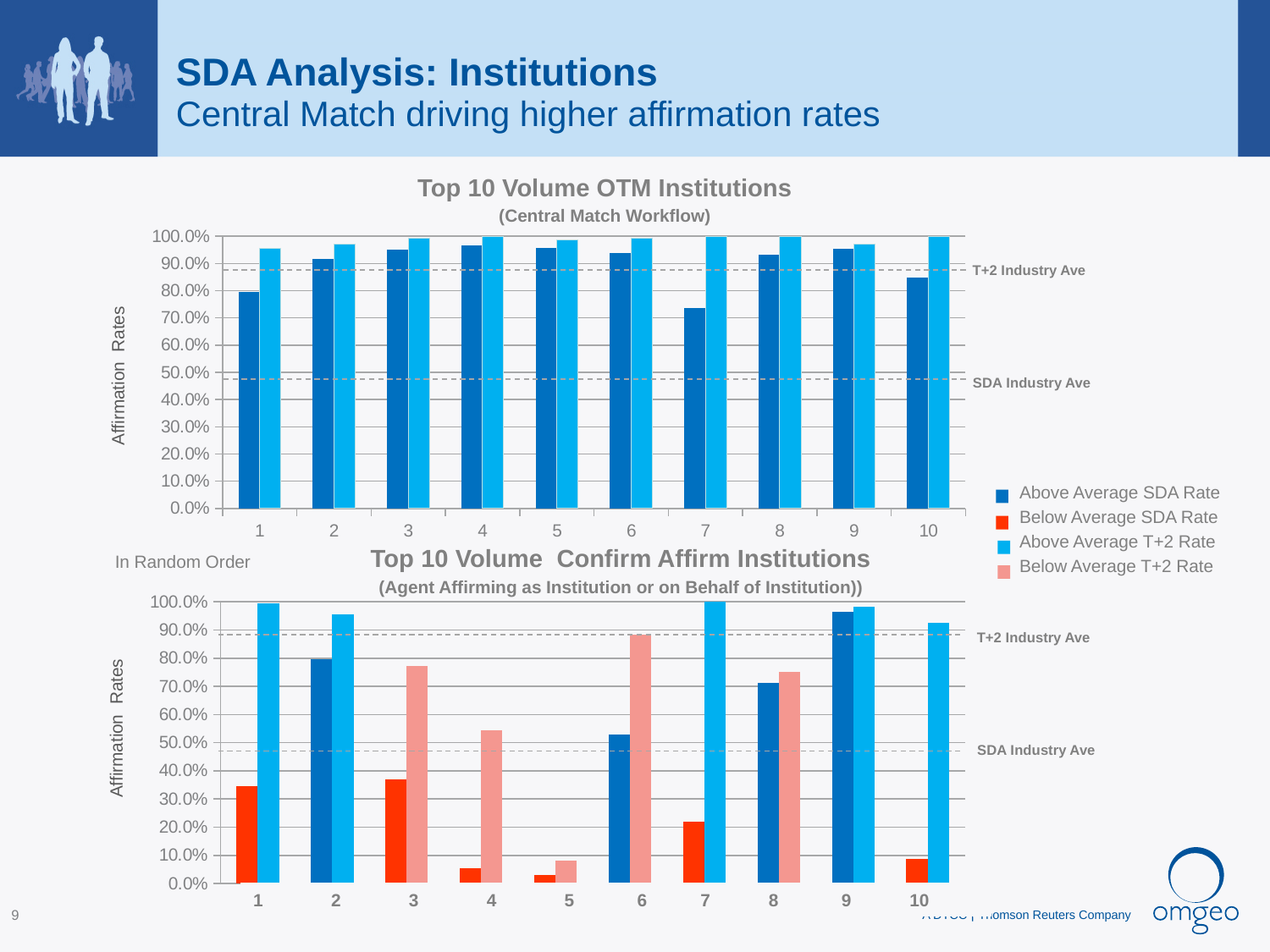
How many institutions are shown on the x axis of the bottom chart, 'Top 10 Volume Confirm Affirm Institutions'? 10 How many series does the shared legend list? 4 What are the two dashed horizontal reference lines on each chart labelled? T+2 Industry Ave and SDA Industry Ave In the bottom chart, 'Top 10 Volume Confirm Affirm Institutions', which has the larger SDA rate, institution 2 or institution 8? institution 2 In the top chart, 'Top 10 Volume OTM Institutions', which institution has the lowest SDA rate (dark blue bar)? 7 In the top chart, 'Top 10 Volume OTM Institutions', which has the larger SDA rate, institution 1 or institution 7? institution 1 In the top chart, 'Top 10 Volume OTM Institutions', is the SDA rate for institution 10 greater or less than 80.0%? greater In the bottom chart, 'Top 10 Volume Confirm Affirm Institutions', which institution has the highest SDA rate? 9 What kind of chart is the top chart, 'Top 10 Volume OTM Institutions'? bar chart In the bottom chart, 'Top 10 Volume Confirm Affirm Institutions', which institution has the lowest T+2 rate? 5 In the bottom chart, 'Top 10 Volume Confirm Affirm Institutions', is the SDA rate for institution 1 greater or less than 40.0%? less In the top chart, 'Top 10 Volume OTM Institutions', is the SDA rate for institution 7 greater or less than 80.0%? less